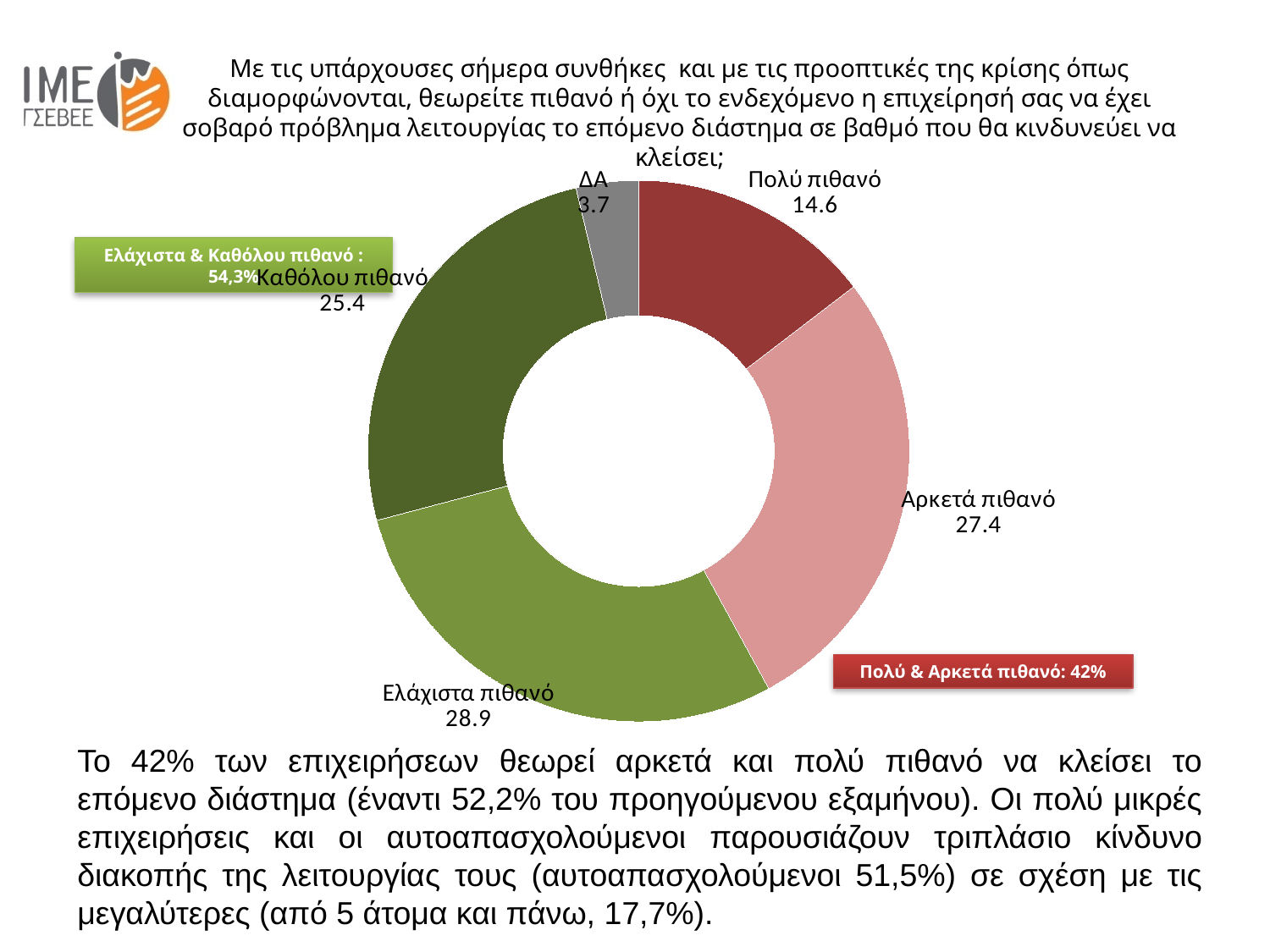
Which is larger, the value for "Καθόλου πιθανό" or the value for "Πολύ πιθανό"? Καθόλου πιθανό What value is shown for the "ΔΑ" slice? 3.7 What value is shown for the "Ελάχιστα πιθανό" slice? 28.9 How many slices does the chart have? 5 Which category has the smallest slice in the chart? ΔΑ What value is shown for the "Πολύ πιθανό" slice? 14.6 What value is shown for the "Αρκετά πιθανό" slice? 27.4 According to the red callout box, what is the combined share of "Πολύ & Αρκετά πιθανό"? 42% What is the difference between the values for "Αρκετά πιθανό" and "Πολύ πιθανό"? 12.8 What value is shown for the "Καθόλου πιθανό" slice? 25.4 Which category has the largest slice in the chart? Ελάχιστα πιθανό What kind of chart is shown on the slide? Doughnut chart